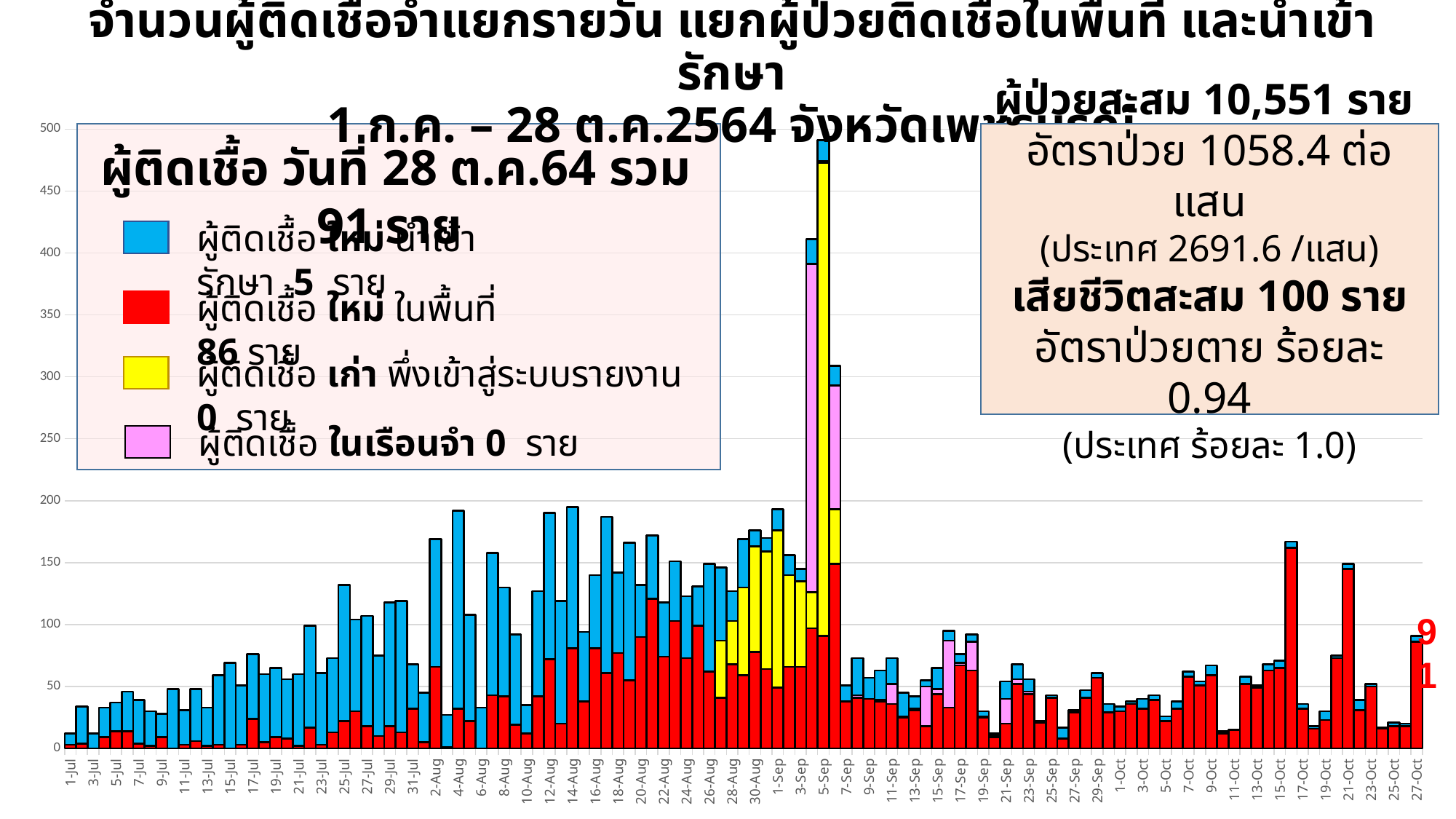
Is the total value for 15-Oct greater or less than 150? less What total value is labelled on the bar for 27-Oct/28 Oct (the last bar)? 91 Which series is shown in red in the legend? ผู้ติดเชื้อ ใหม่ ในพื้นที่ Which colour in the legend represents cases in prison (ผู้ติดเชื้อ ในเรือนจำ)? pink On which date does the chart show the tallest bar? 5-Sep Which bar is taller, 4-Aug or 6-Aug? 4-Aug What kind of chart is shown on the slide? bar chart Is the total value for 5-Sep greater or less than 450? greater How many series does the chart legend list? 4 According to the slide, how many new imported cases (ผู้ติดเชื้อใหม่ นำเข้ารักษา) were reported on 28 Oct 64? 5 ราย Is the total value for 1-Jul greater or less than 50? less According to the slide, how many new local cases (ผู้ติดเชื้อใหม่ ในพื้นที่) were reported on 28 Oct 64? 86 ราย